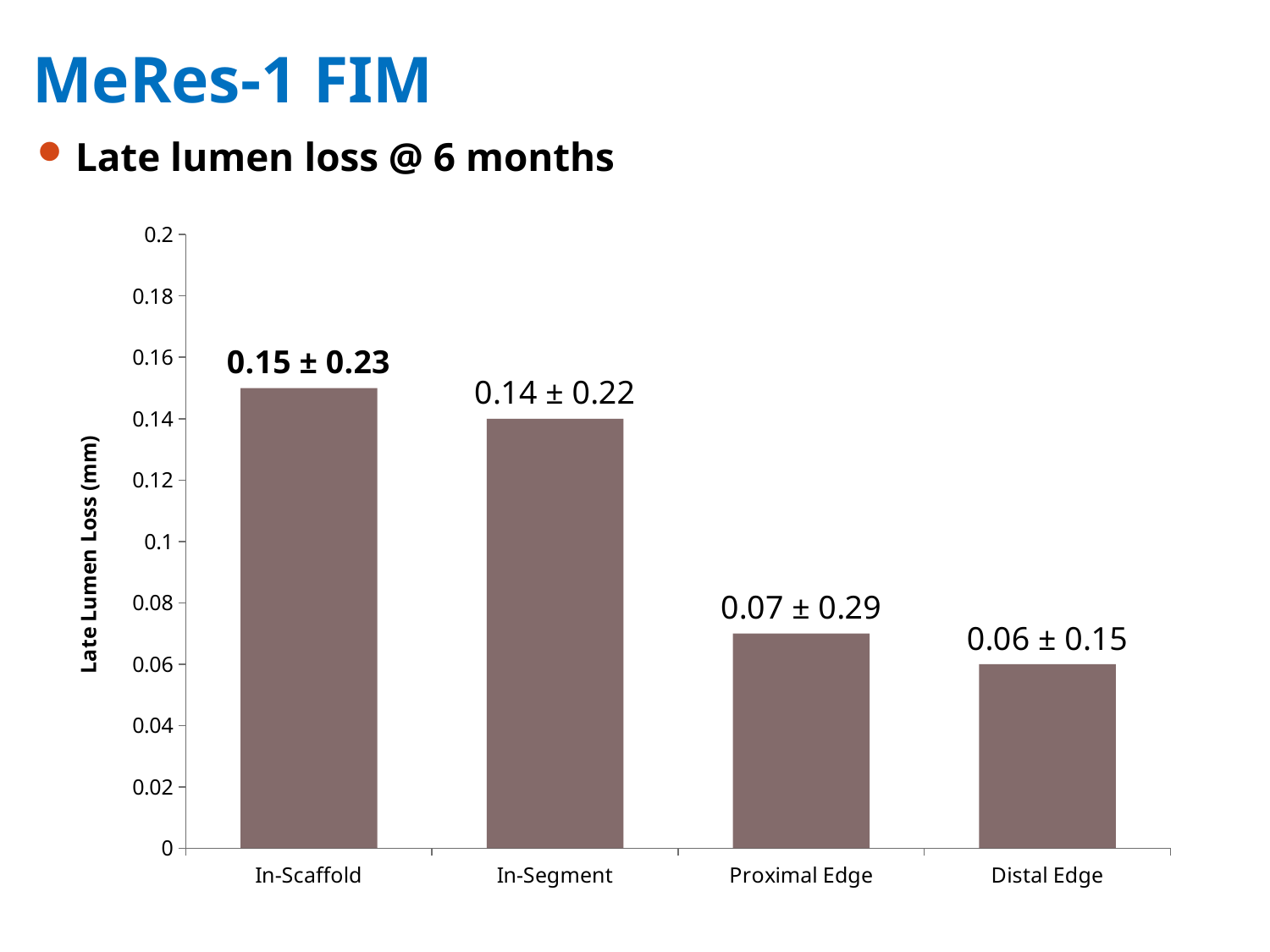
What is the difference between the mean late lumen loss for In-Scaffold and In-Segment? 0.01 Which has a larger mean late lumen loss, In-Segment or Proximal Edge? In-Segment What is the late lumen loss value shown for Distal Edge? 0.06 ± 0.15 Which category has the highest late lumen loss? In-Scaffold How many categories are shown on the x axis? 4 Which category has the lowest late lumen loss? Distal Edge What kind of chart is shown on the slide? bar chart What is the late lumen loss value shown for In-Scaffold? 0.15 ± 0.23 Do the values rise or fall from left to right along the x axis? fall What is the label of the y axis? Late Lumen Loss (mm) What is the late lumen loss value shown for Proximal Edge? 0.07 ± 0.29 Is the value for Proximal Edge greater or less than 0.1? less